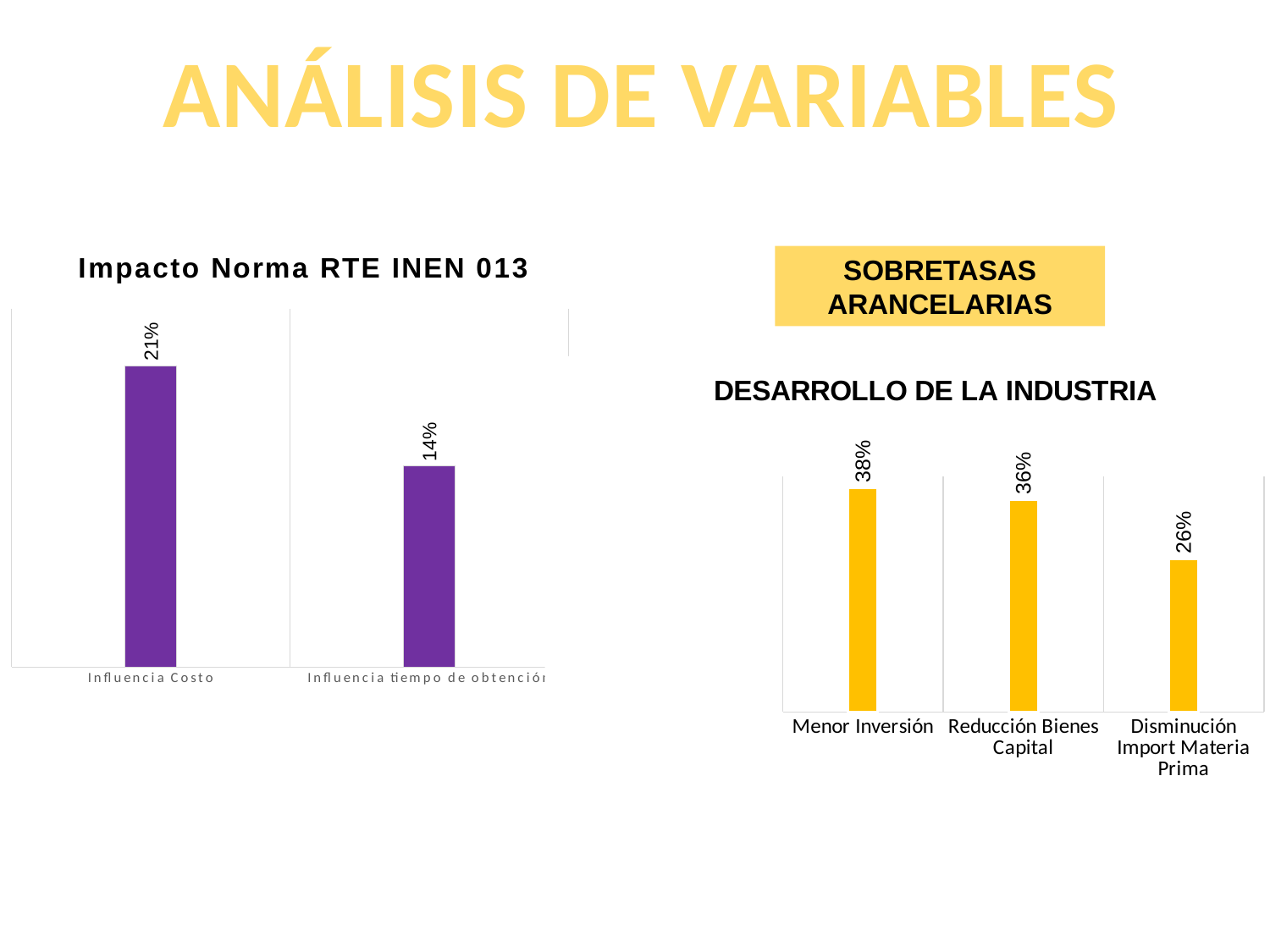
In the 'Impacto Norma RTE INEN 013' chart, what is the value for Influencia tiempo de obtención? 14% In the 'DESARROLLO DE LA INDUSTRIA' chart, what is the difference between Reducción Bienes Capital and Disminución Import Materia Prima? 10% In the 'Impacto Norma RTE INEN 013' chart, what is the value for Influencia Costo? 21% In the 'DESARROLLO DE LA INDUSTRIA' chart, what colour are the bars? Yellow In the 'Impacto Norma RTE INEN 013' chart, which category has the highest value? Influencia Costo In the 'DESARROLLO DE LA INDUSTRIA' chart, how many categories are plotted? 3 In the 'DESARROLLO DE LA INDUSTRIA' chart, what is the value for Disminución Import Materia Prima? 26% In the 'Impacto Norma RTE INEN 013' chart, what is the difference between Influencia Costo and Influencia tiempo de obtención? 7% In the 'DESARROLLO DE LA INDUSTRIA' chart, which category has the lowest value? Disminución Import Materia Prima What type of chart is 'Impacto Norma RTE INEN 013'? Bar chart In the 'Impacto Norma RTE INEN 013' chart, how many categories are plotted? 2 In the 'DESARROLLO DE LA INDUSTRIA' chart, what is the value for Menor Inversión? 38%